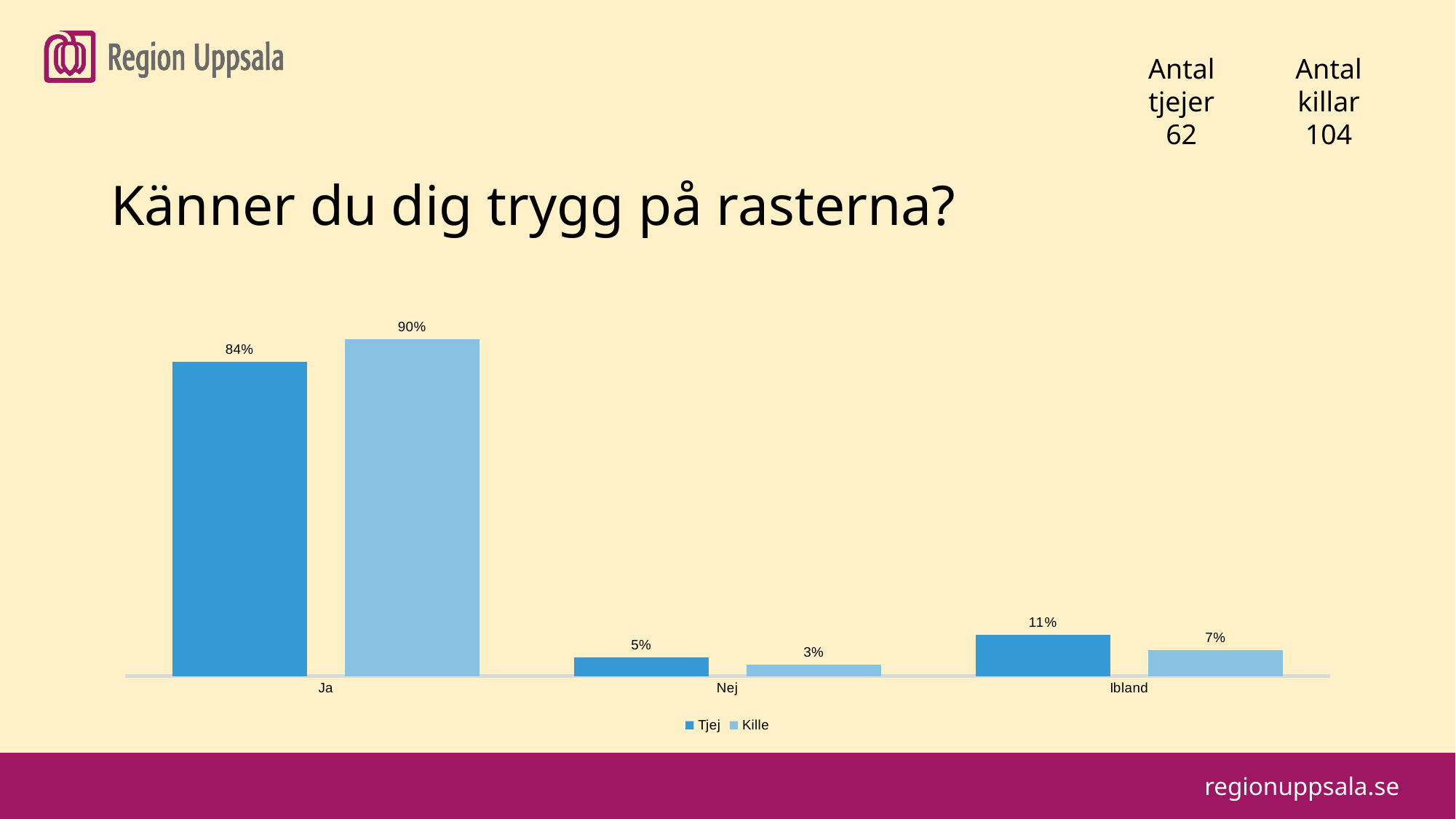
How many categories are shown on the x axis? 3 What is the value for Kille in the Ja category? 90% What is the title of the chart on the slide? Känner du dig trygg på rasterna? What is the difference between the Kille and Tjej values in the Ja category? 6% What is the value for Tjej in the Nej category? 5% What is the value for Kille in the Ibland category? 7% In the Ibland category, which series has the larger value, Tjej or Kille? Tjej How many series does the legend list? 2 What is the value for Tjej in the Ja category? 84% What kind of chart is shown on the slide? Bar chart Which category has the highest value for Kille? Ja Which category has the lowest value for Tjej? Nej